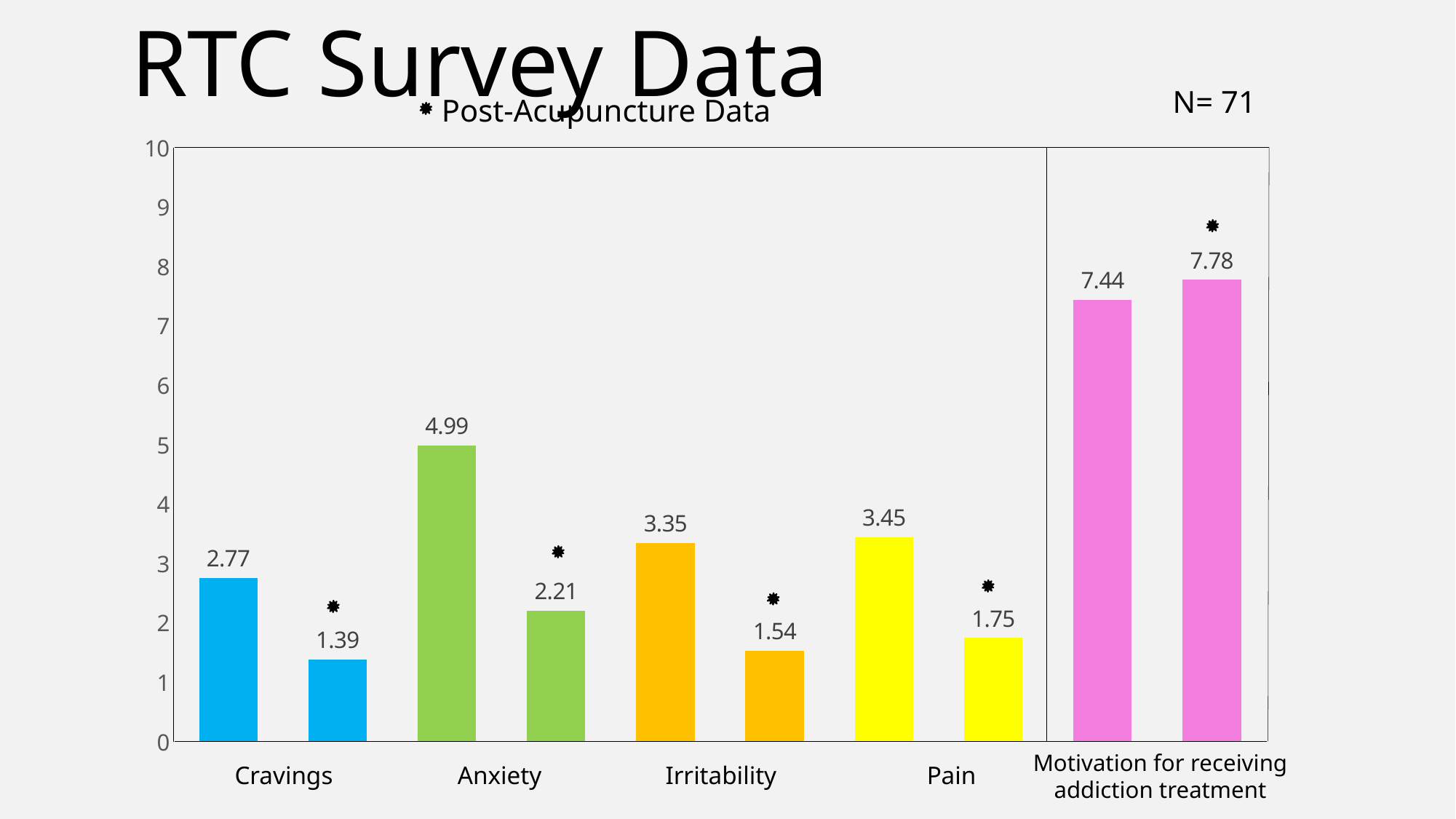
Is the post-acupuncture value for Motivation for receiving addiction treatment greater or less than 7? greater Which category has the lowest post-acupuncture value? Cravings What is the difference between the pre- and post-acupuncture values for Anxiety? 2.78 What is the pre-acupuncture value for Anxiety? 4.99 What is the post-acupuncture value for Motivation for receiving addiction treatment? 7.78 What kind of chart is shown on the slide? Bar chart What is the difference between the pre- and post-acupuncture values for Irritability? 1.81 How many categories are shown on the x axis? 5 Which category has the highest pre-acupuncture value? Motivation for receiving addiction treatment What is the post-acupuncture value (marked with the asterisk) for Cravings? 1.39 Which is larger, the pre-acupuncture value for Pain or the pre-acupuncture value for Irritability? Pain What sample size (N) is stated on the slide? N= 71